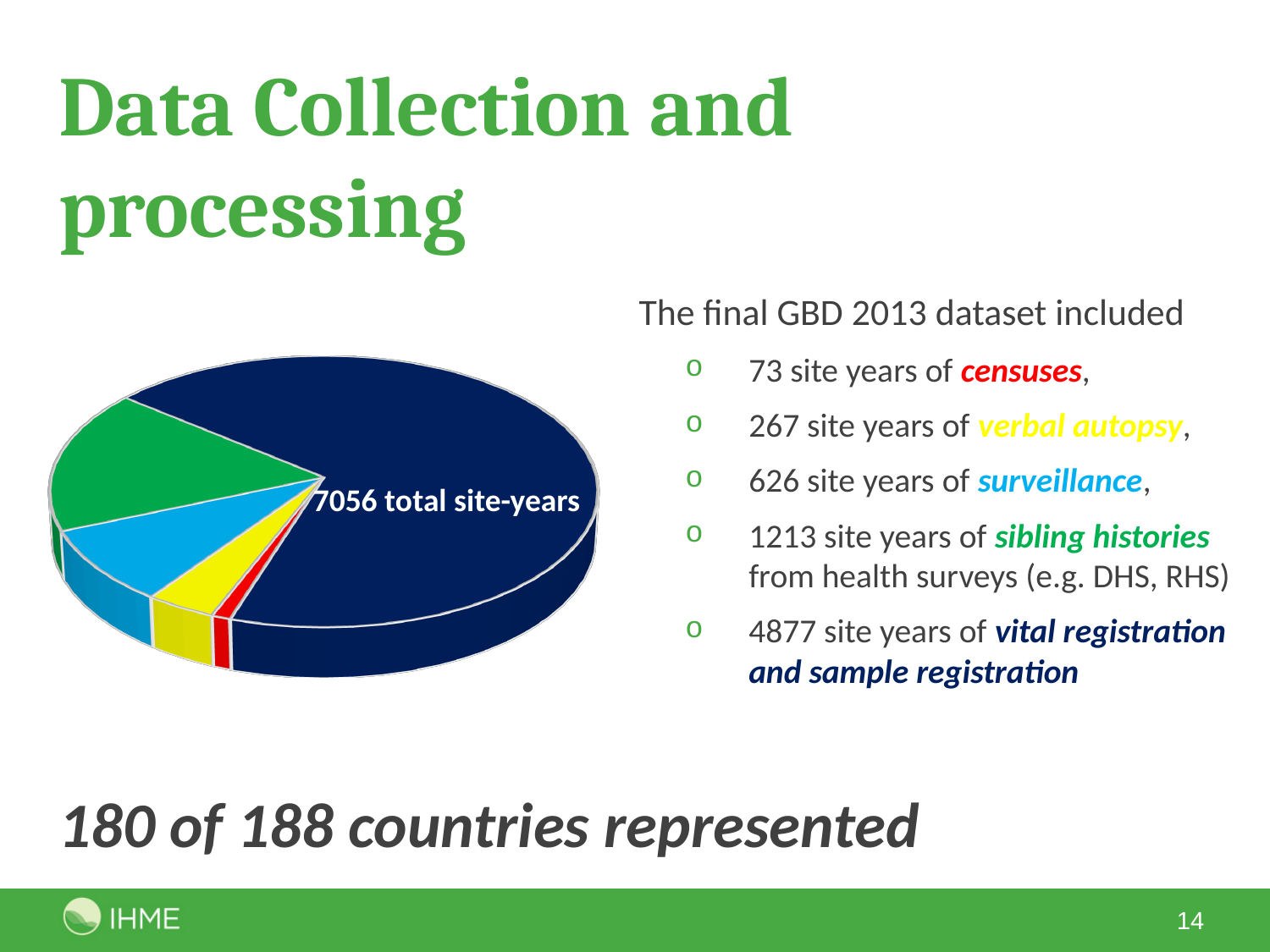
What total is printed on the pie chart? 7056 total site-years Which data source accounts for the smallest slice of the pie chart? Censuses How many site years of sibling histories from health surveys are in the dataset? 1213 What kind of chart is shown on the slide? Pie chart How many more site years of vital registration and sample registration are there than sibling histories? 3664 How many slices does the pie chart have? 5 Which has more site years, surveillance or verbal autopsy? Surveillance How many site years of verbal autopsy are in the dataset? 267 How many site years of surveillance are in the dataset? 626 Which data source accounts for the largest slice of the pie chart? Vital registration and sample registration What colour is the slice representing vital registration and sample registration? Dark blue How many site years of censuses are in the dataset? 73